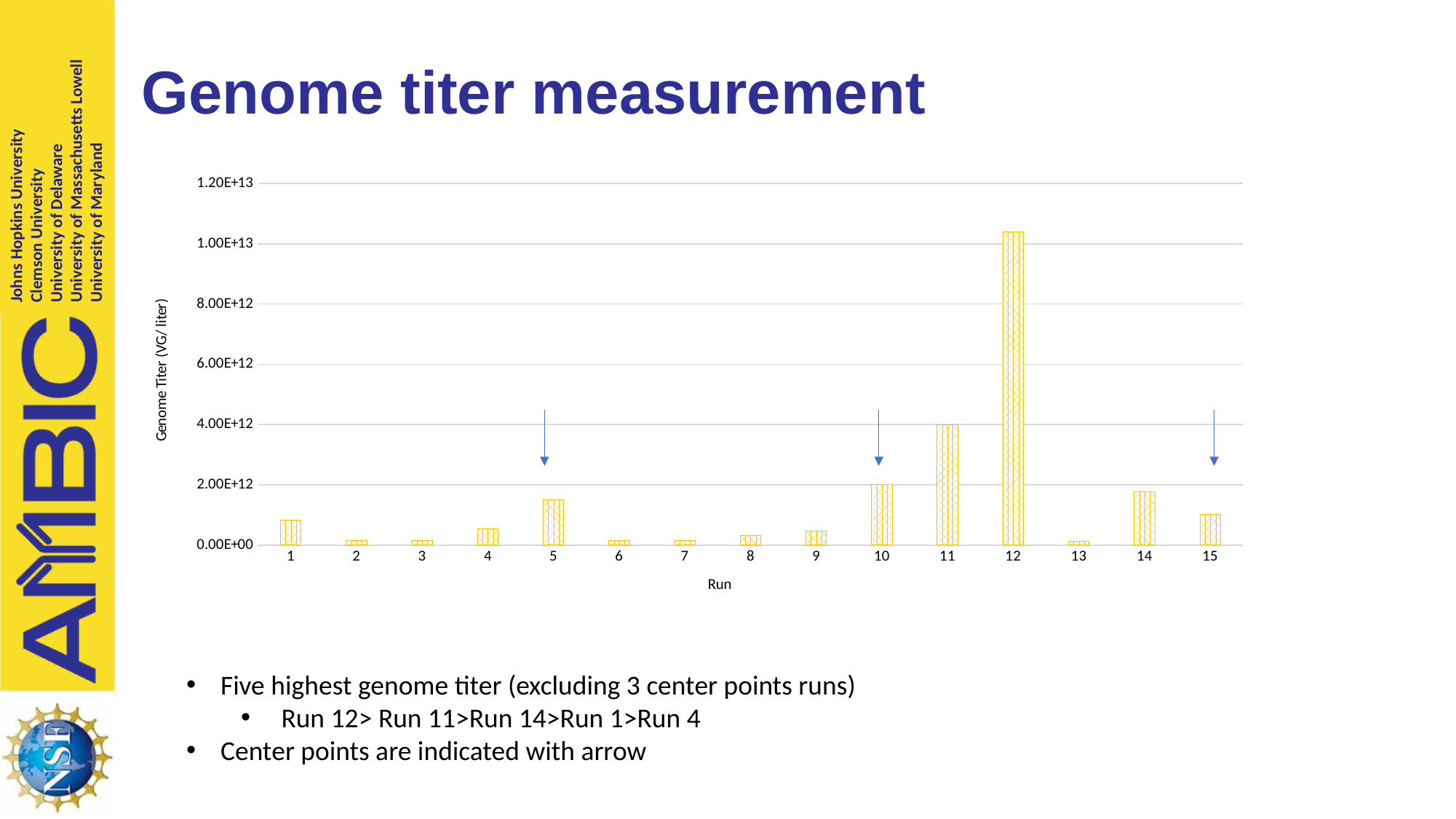
What kind of chart is shown on the slide? bar chart Is the genome titer for Run 1 greater or less than 2.00E+12? less Is the genome titer for Run 11 greater or less than 6.00E+12? less Which has the higher genome titer, Run 11 or Run 14? Run 11 What is the label of the y axis? Genome Titer (VG/ liter) Which has the higher genome titer, Run 10 or Run 15? Run 10 Is the genome titer for Run 12 greater or less than 1.00E+13? greater How many runs are plotted along the x axis? 15 Which run has the highest genome titer? Run 12 Which has the higher genome titer, Run 1 or Run 4? Run 1